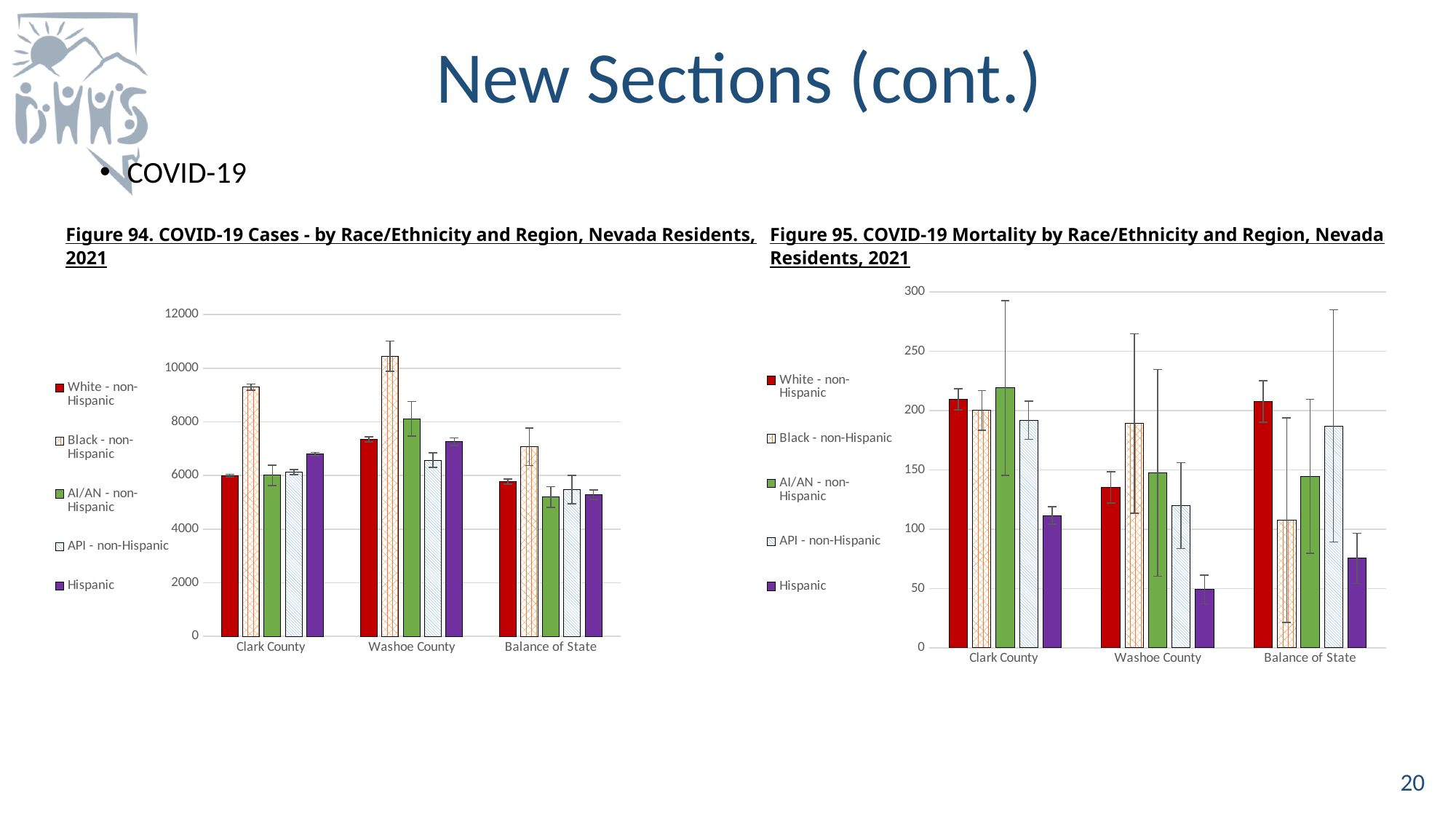
In Figure 95 (COVID-19 Mortality), which race/ethnicity group has the lowest value in Washoe County? Hispanic What is the title of the chart on the right side of the slide? Figure 95. COVID-19 Mortality by Race/Ethnicity and Region, Nevada Residents, 2021 In Figure 94 (COVID-19 Cases), how many series does the legend list? 5 In Figure 94 (COVID-19 Cases), which is larger: the White - non-Hispanic value for Washoe County or for Balance of State? Washoe County In Figure 95 (COVID-19 Mortality), is the value for Black - non-Hispanic in Washoe County greater or less than 150? greater In Figure 95 (COVID-19 Mortality), which race/ethnicity group has the lowest value in Balance of State? Hispanic In Figure 94 (COVID-19 Cases), how many regions are shown on the x axis? 3 What kind of chart is Figure 94 (COVID-19 Cases by Race/Ethnicity and Region)? Bar chart In Figure 94 (COVID-19 Cases), is the value for Black - non-Hispanic in Clark County greater or less than 8000? greater In Figure 94 (COVID-19 Cases), is the value for AI/AN - non-Hispanic in Balance of State greater or less than 6000? less In Figure 94 (COVID-19 Cases), which race/ethnicity group has the highest value in Washoe County? Black - non-Hispanic